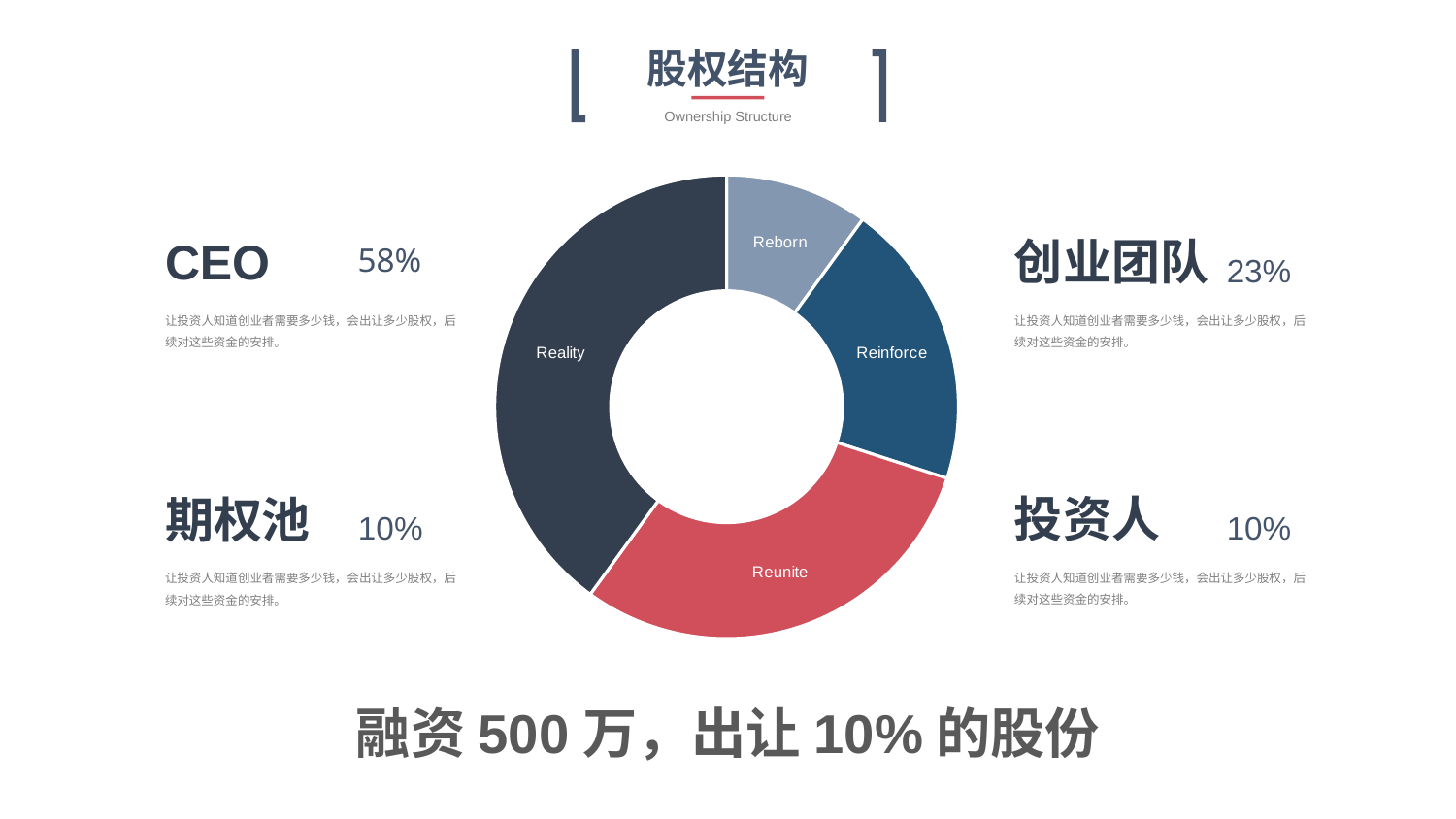
Which slice of the pie chart is the largest? Reality Is the share of the Reality slice greater or less than 50%? less What kind of chart is shown on the slide? doughnut chart Which slice is larger, Reality or Reunite? Reality How many slices does the pie chart have? 4 Is the share of the Reborn slice greater or less than 25%? less Which slice is larger, Reunite or Reinforce? Reunite What is the title of the slide containing the chart? 股权结构 Which slice is larger, Reinforce or Reborn? Reinforce What English subtitle appears under the slide title? Ownership Structure Which slice of the pie chart is the smallest? Reborn